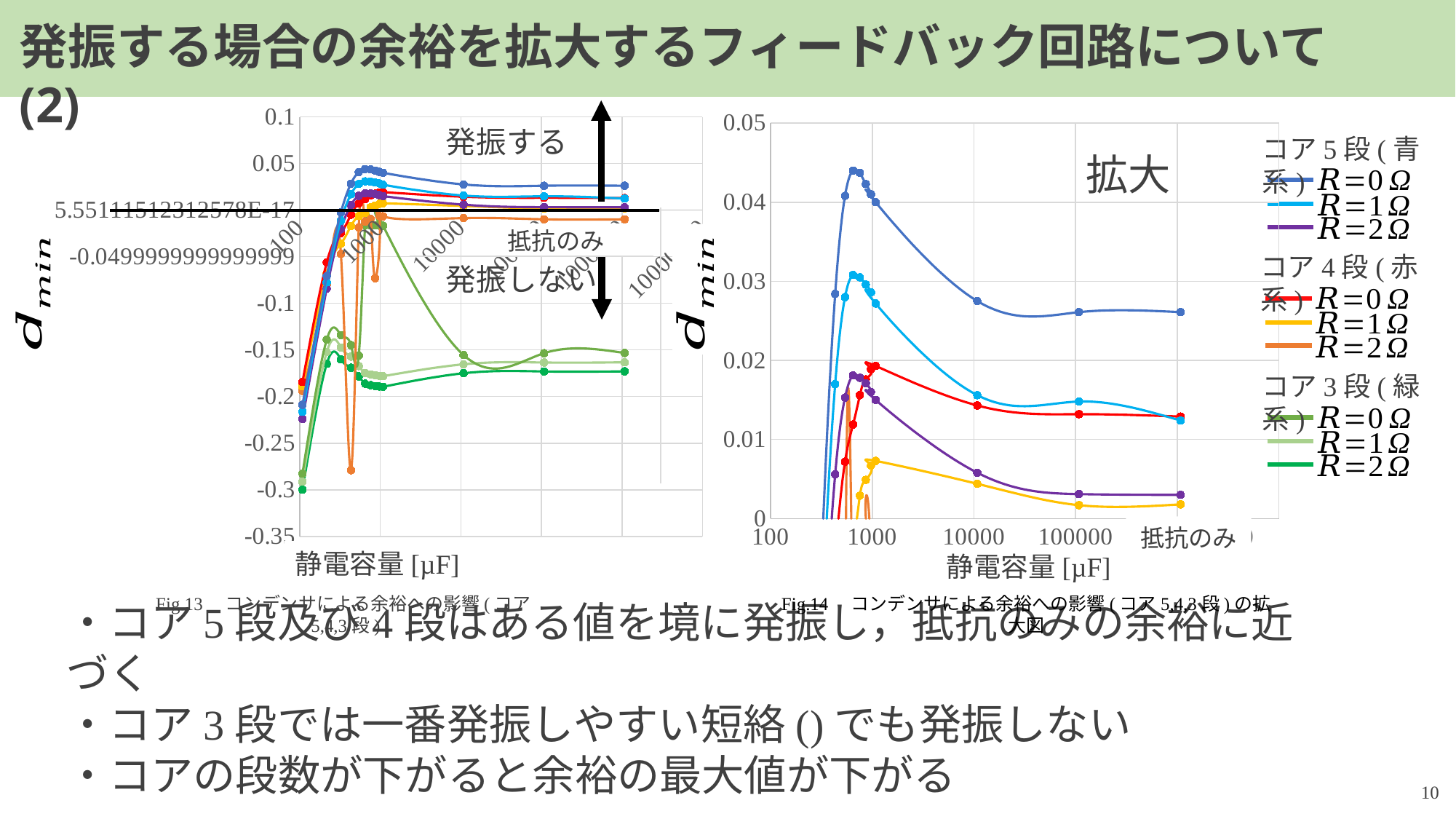
In Fig.14 (right chart), does the コア5段 R=0Ω series rise or fall between 1000 and 10000 on the x axis? fall What is the x-axis label of Fig.14 (right chart)? 静電容量 [µF] In Fig.14 (right chart), is the value of the コア5段 R=0Ω series at 抵抗のみ greater or less than 0.02? greater How many series does the legend on the right of the slide list? 9 In Fig.14 (right chart), which series reaches the highest value? コア5段 R=0Ω In Fig.14 (right chart), is the peak value of the コア5段 R=0Ω series greater or less than 0.04? greater In Fig.14 (right chart), at 抵抗のみ, which is larger: the コア5段 R=0Ω series or the コア4段 R=0Ω series? コア5段 R=0Ω In Fig.13 (left chart), is the value of the コア3段 R=2Ω series at the right end greater or less than -0.15? less In Fig.13 (left chart), which series reaches the lowest value? コア3段 R=2Ω What is the highest tick value shown on the y axis of Fig.14 (right chart)? 0.05 What kind of chart is Fig.13 on the left of the slide? line chart